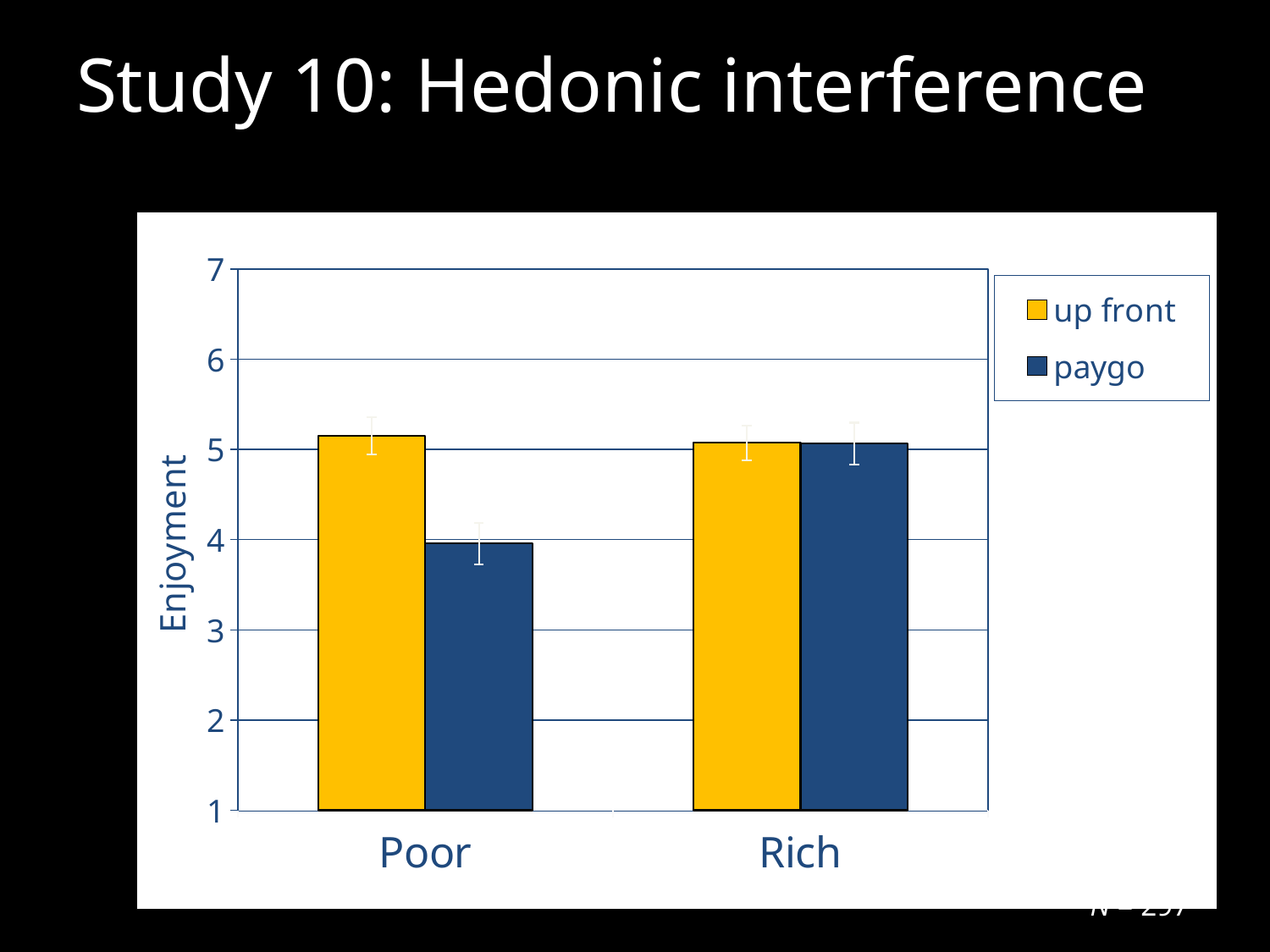
Is the value for paygo in the Rich category greater or less than 4? greater How many series does the legend list? 2 What kind of chart is shown on the slide? bar chart What are the two series named in the legend? up front, paygo How many categories are shown on the x axis? 2 Is the value for paygo in the Poor category greater or less than 5? less For the Poor category, which is larger: up front or paygo? up front Which bar is the lowest in the chart? Poor, paygo What is the label on the y axis? Enjoyment Is the value for up front in the Rich category greater or less than 6? less